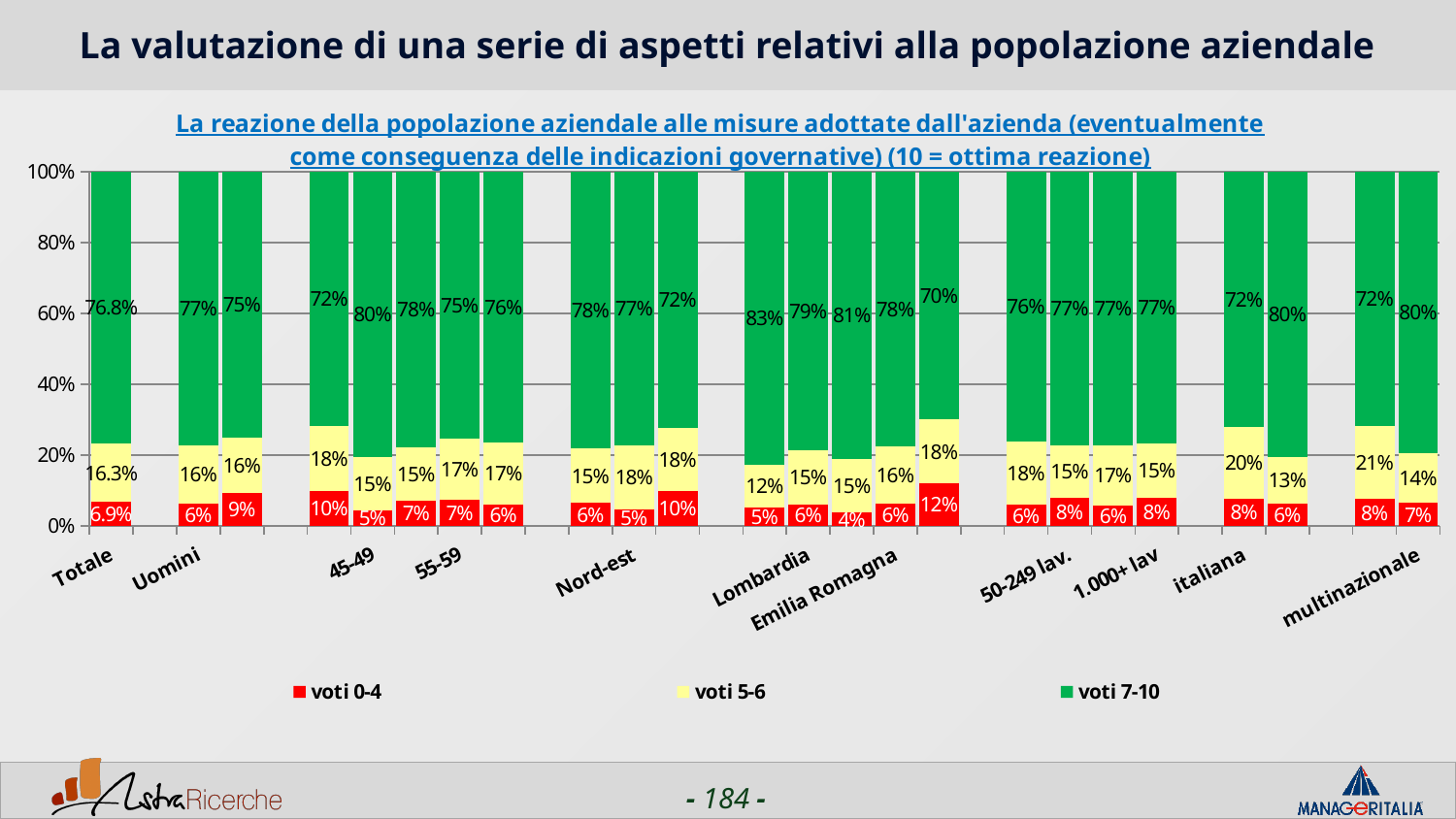
Which has the larger 'voti 0-4' value, Totale or Uomini? Totale What is the value of 'voti 0-4' for Totale? 6.9% What is the value of 'voti 5-6' for italiana? 20% What is the value of 'voti 5-6' for Uomini? 16% What are the three series listed in the legend? voti 0-4, voti 5-6, voti 7-10 What is the value of 'voti 7-10' for Totale? 76.8% What is the value of 'voti 5-6' for Totale? 16.3% What is the value of 'voti 7-10' for Uomini? 77% How many series does the legend list? 3 What is the value of 'voti 7-10' for 45-49? 80% What kind of chart is shown on the slide? stacked bar chart Which colour represents 'voti 7-10' in the chart? green